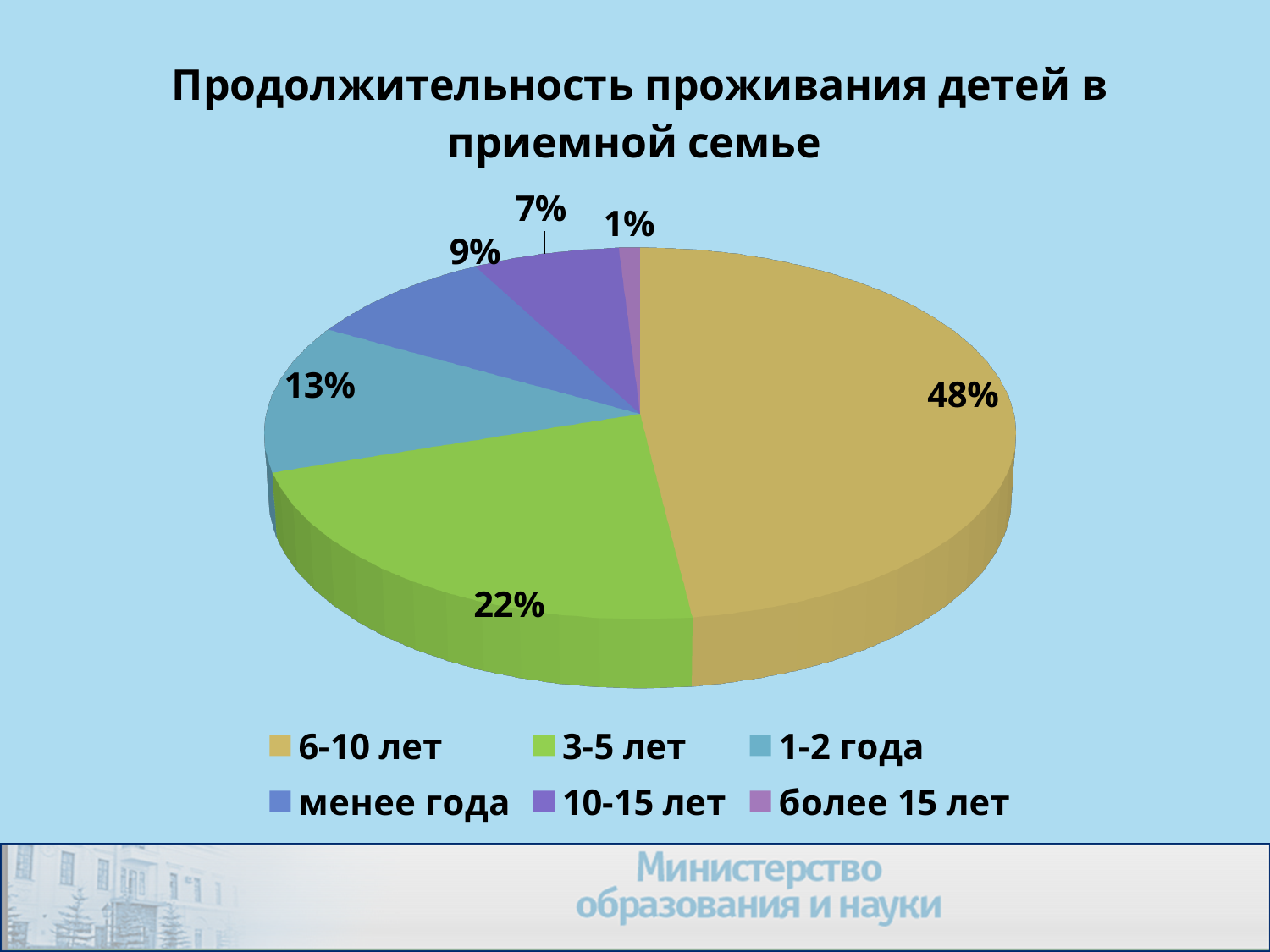
Which category has the largest share of the pie? 6-10 лет What is the value shown for the '3-5 лет' category? 22% Which is larger, the share for '1-2 года' or the share for 'менее года'? 1-2 года What is the value shown for the 'менее года' category? 9% What is the value shown for the '10-15 лет' category? 7% What kind of chart is shown on the slide? Pie chart How many categories are shown in the pie chart? 6 What is the value shown for the '1-2 года' category? 13% Which category has the smallest share of the pie? более 15 лет What is the title of the chart? Продолжительность проживания детей в приемной семье What is the difference between the shares for '6-10 лет' and '3-5 лет'? 26% What share of the pie does the '6-10 лет' slice represent? 48%